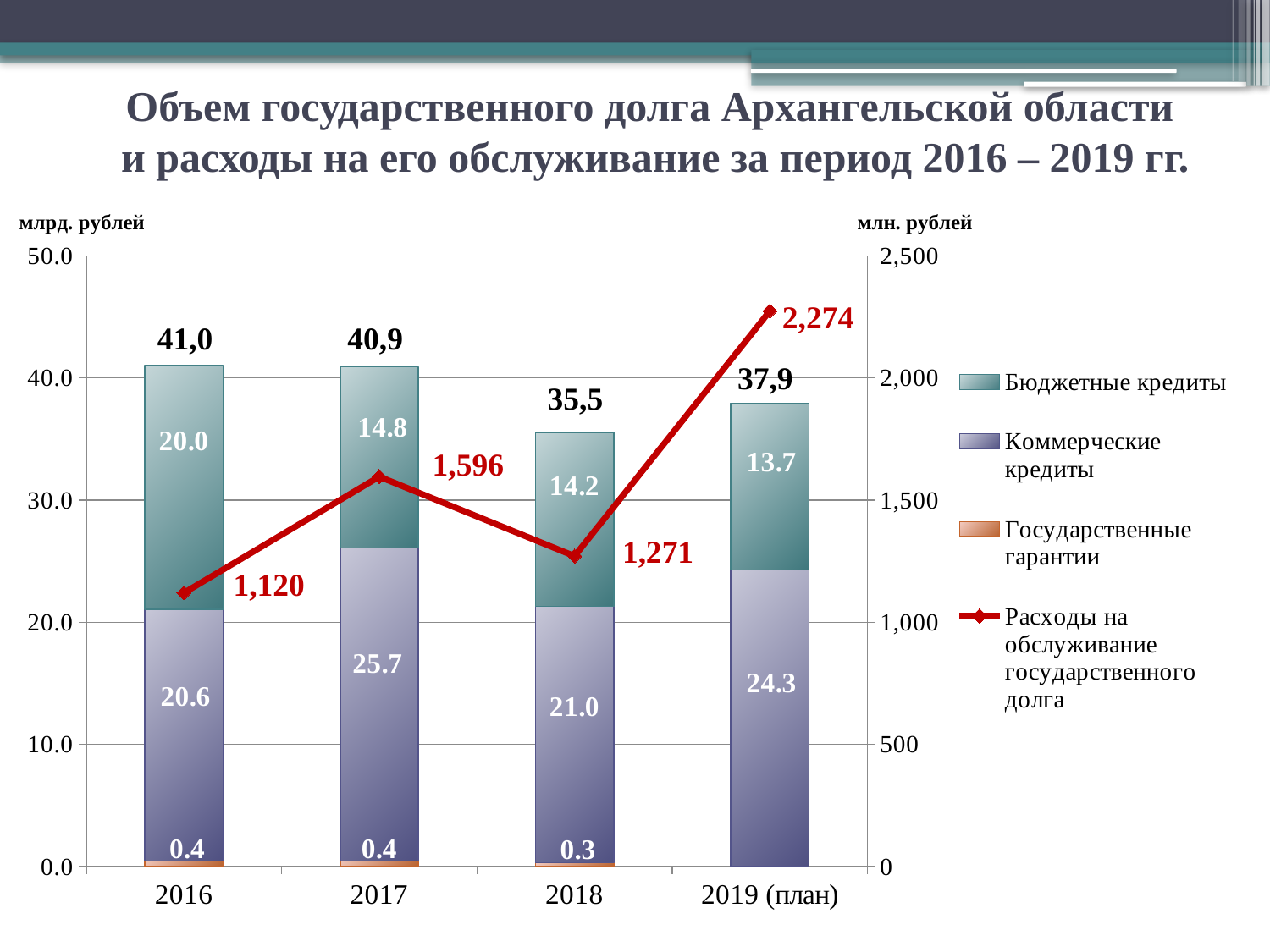
Which is larger: Коммерческие кредиты in 2017 or in 2018? 2017 In which year is Расходы на обслуживание государственного долга the highest? 2019 (план) What is the value of Бюджетные кредиты for 2016? 20.0 What is the total of the stacked bar for 2018? 35,5 How many years are shown on the x axis? 4 Does the value of Бюджетные кредиты rise or fall from 2016 to 2019 (план)? fall What is the value of Коммерческие кредиты for 2017? 25.7 What is the value of Расходы на обслуживание государственного долга for 2019 (план)? 2,274 In which year is Расходы на обслуживание государственного долга the lowest? 2016 What is the value of Государственные гарантии for 2018? 0.3 How many series does the legend list? 4 What is the difference between Расходы на обслуживание государственного долга in 2019 (план) and in 2018? 1,003